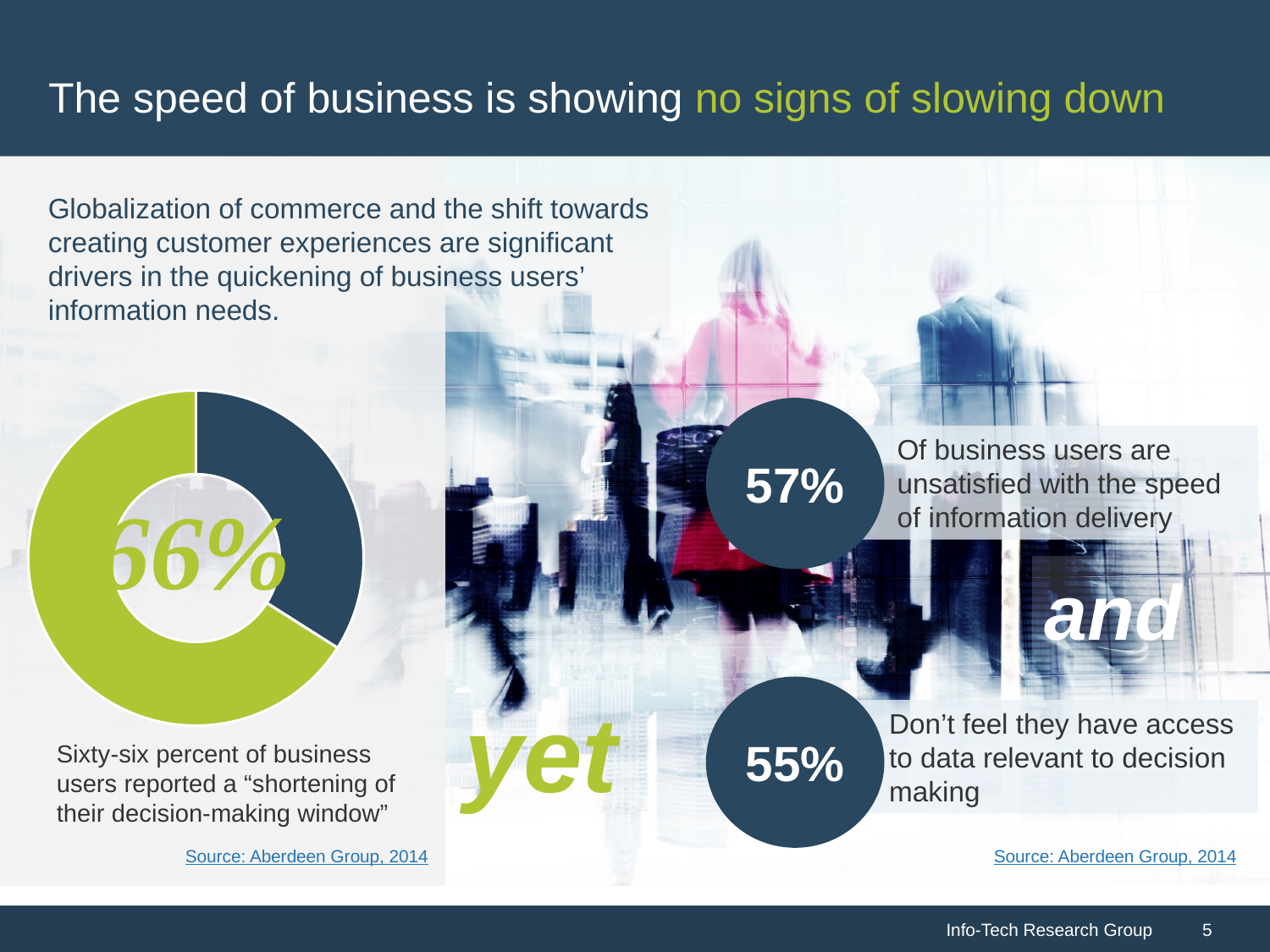
How many slices does the doughnut chart have? 2 What kind of chart is shown on the left side of the slide? Doughnut (pie) chart Is the green slice of the doughnut chart greater or less than 50% of the whole? greater Which slice of the doughnut chart is larger, the green one or the dark blue one? The green one According to the caption under the doughnut chart, what did sixty-six percent of business users report? A "shortening of their decision-making window" What share of the doughnut chart does the green slice represent? 66% Is the dark blue slice of the doughnut chart greater or less than 50% of the whole? less What percentage is printed in the centre of the doughnut chart? 66% What colour is the larger slice of the doughnut chart? Green